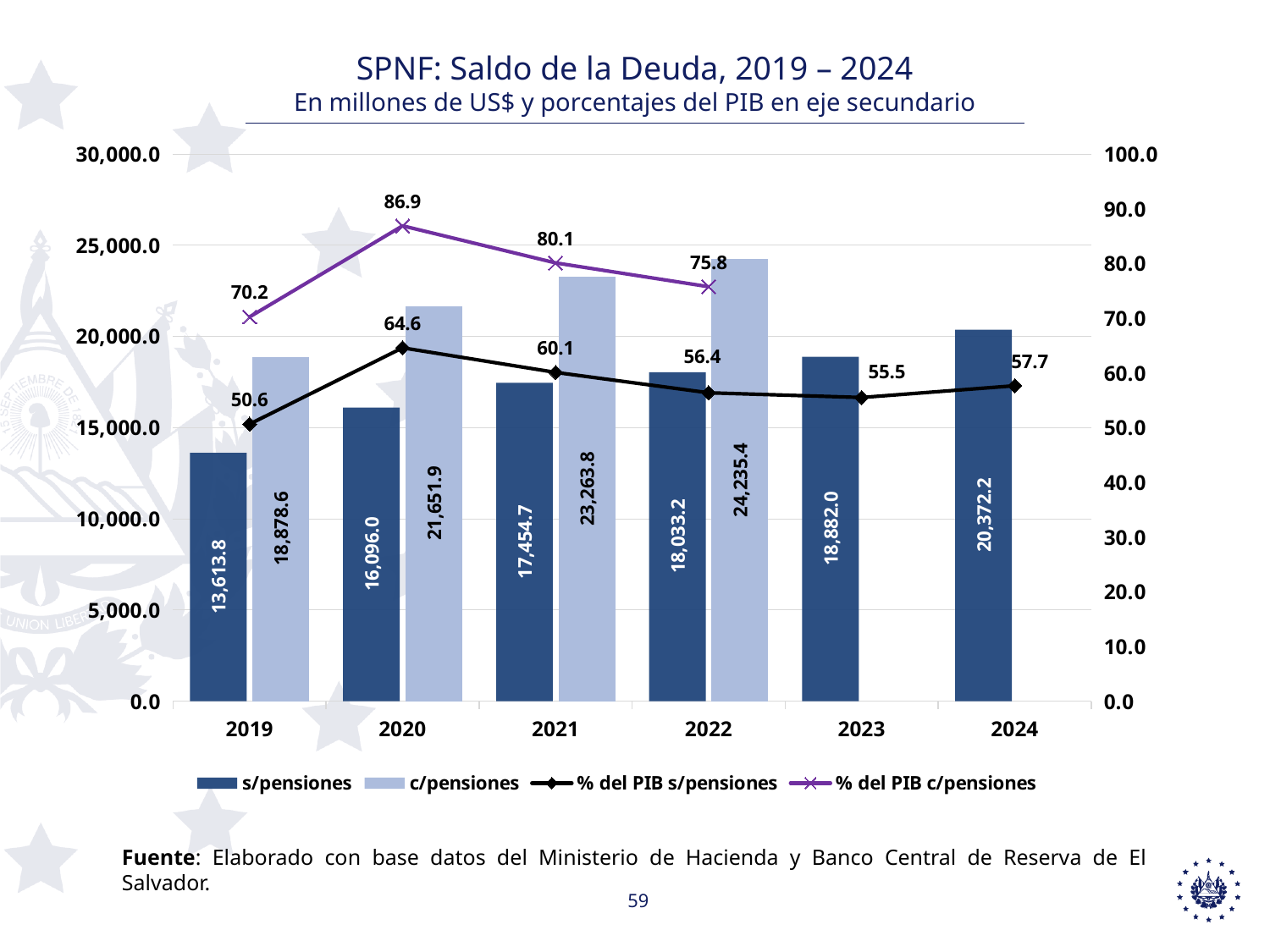
What is the value of s/pensiones for 2024? 20,372.2 Which year has the highest % del PIB s/pensiones value? 2020 What is the value of c/pensiones for 2021? 23,263.8 Do the s/pensiones values rise or fall from 2019 to 2024? Rise How many series does the legend list? 4 What is the % del PIB c/pensiones value for 2020? 86.9 How many years are shown on the x axis? 6 What is the % del PIB s/pensiones value for 2023? 55.5 Which year has the lowest s/pensiones value? 2019 What is the difference between the c/pensiones and s/pensiones values for 2022? 6,202.2 What kind of chart is this? Combined bar and line chart Which is larger, the s/pensiones value for 2023 or the c/pensiones value for 2019? s/pensiones for 2023